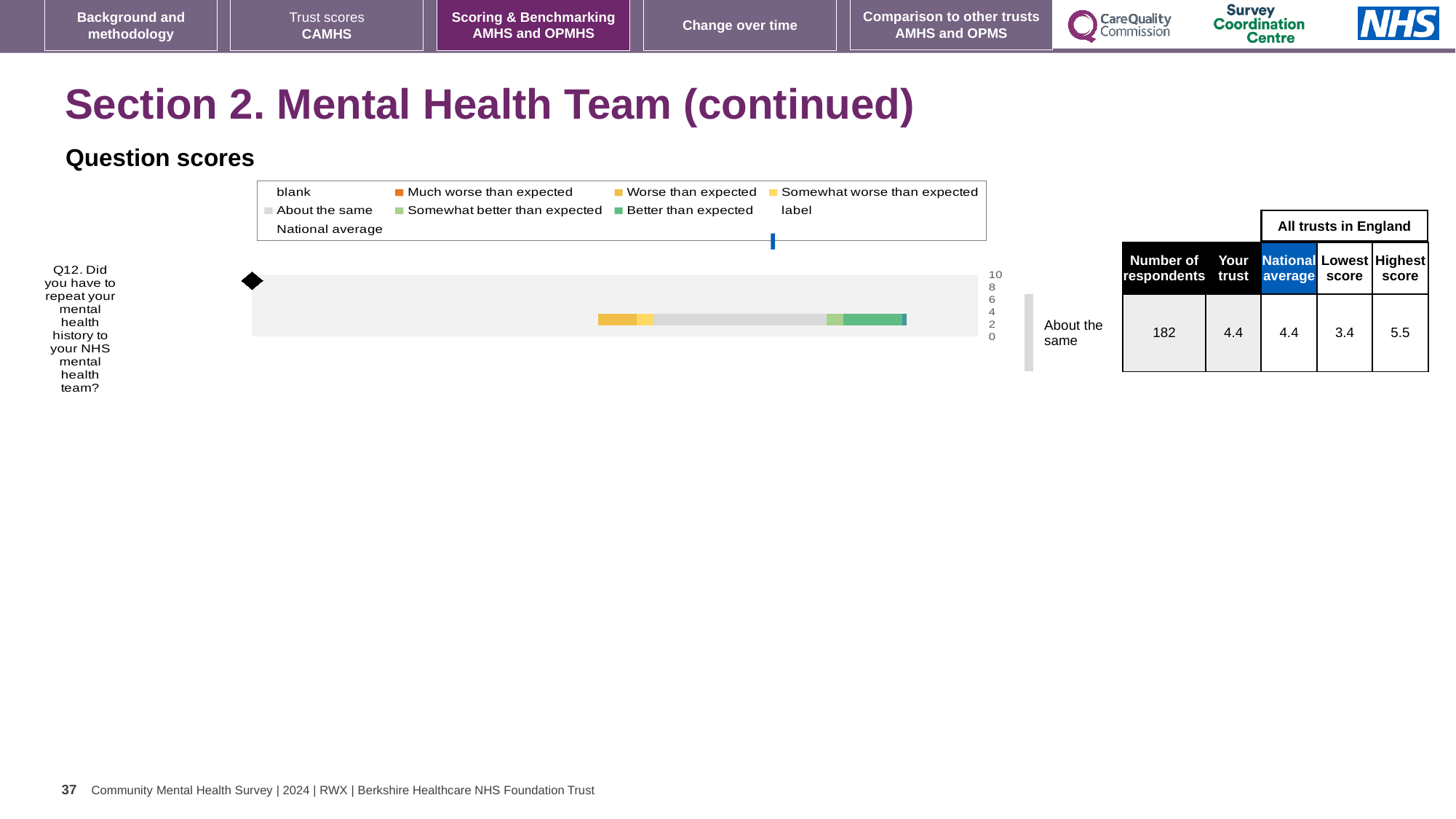
In the table next to the chart, what is the national average score for Q12? 4.4 In the table next to the chart, what is the lowest score among all trusts in England for Q12? 3.4 In the table next to the chart, what is the 'Your trust' score for Q12? 4.4 Which question is plotted in the chart? Q12. Did you have to repeat your mental health history to your NHS mental health team? What kind of chart is shown under 'Question scores'? bar chart In the table next to the chart, what is the highest score among all trusts in England for Q12? 5.5 What is the highest tick value shown on the chart's axis? 10 In the table next to the chart, is the 'Your trust' score for Q12 higher than, lower than, or equal to the national average? equal How many questions (categories) are plotted in the chart? 1 In the table next to the chart, what is the number of respondents for Q12? 182 In the table next to the chart, what is the difference between the highest score and the lowest score for Q12? 2.1 What benchmark rating is shown to the right of the bar for Q12? About the same